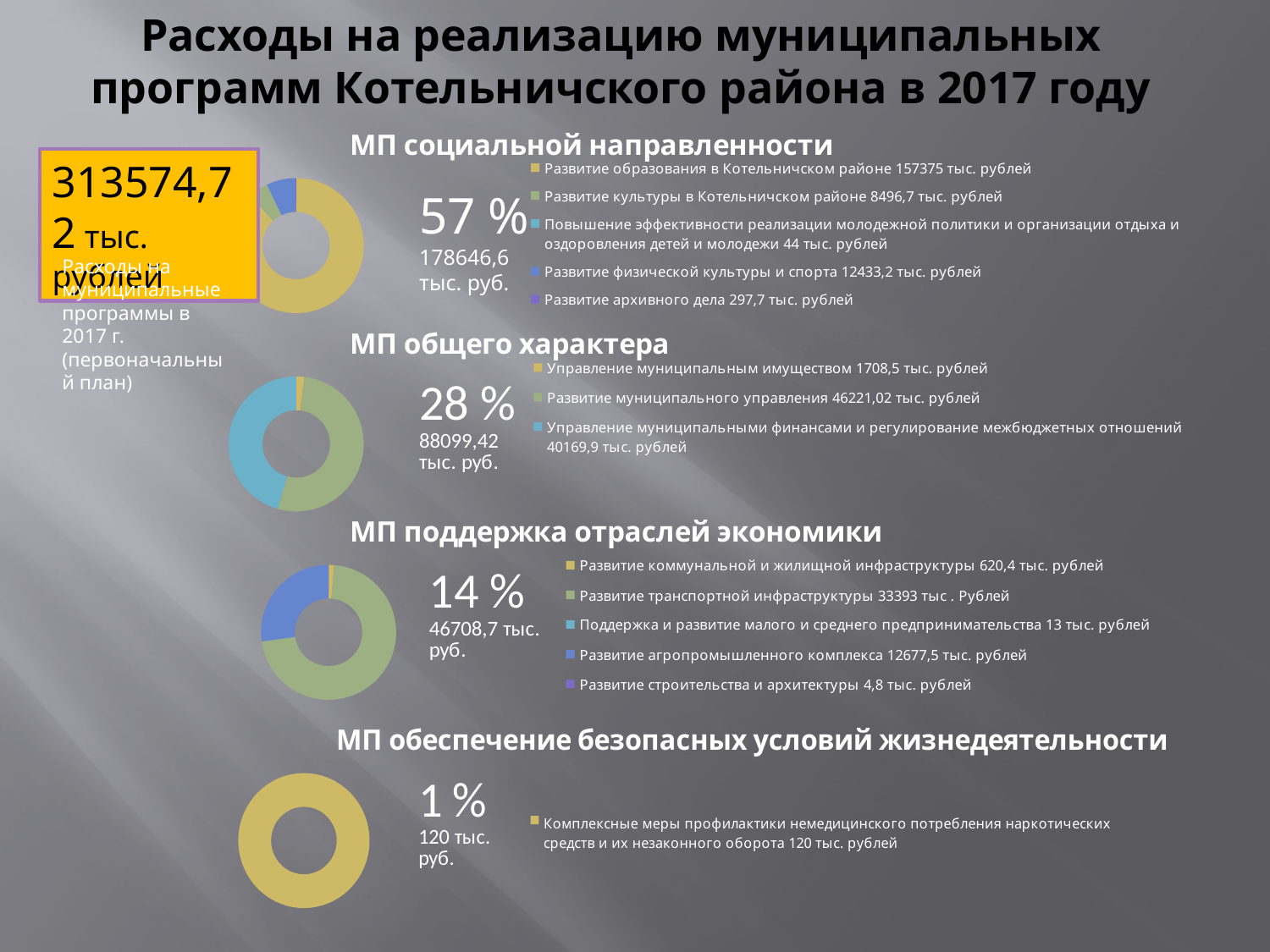
What total amount in тыс. руб. is shown next to the "МП обеспечение безопасных условий жизнедеятельности" chart? 120 тыс. руб. In the "МП поддержка отраслей экономики" chart, what is the value for "Развитие агропромышленного комплекса"? 12677,5 тыс. рублей How many categories does the legend of the "МП социальной направленности" chart list? 5 In the "МП общего характера" chart, which category has the highest value? Развитие муниципального управления What kind of chart is used for "МП социальной направленности"? Doughnut (pie) chart What share of total expenditure does the "МП общего характера" chart represent? 28 % In the "МП поддержка отраслей экономики" chart, which is larger: "Развитие транспортной инфраструктуры" or "Развитие коммунальной и жилищной инфраструктуры"? Развитие транспортной инфраструктуры In the "МП социальной направленности" chart, which category has the lowest value? Повышение эффективности реализации молодежной политики и организации отдыха и оздоровления детей и молодежи In the "МП социальной направленности" chart, what is the value for "Развитие образования в Котельничском районе"? 157375 тыс. рублей What total expenditure on municipal programmes is shown in the yellow box on the slide? 313574,72 тыс. рублей How many categories does the legend of the "МП поддержка отраслей экономики" chart list? 5 In the "МП общего характера" chart, what is the difference between "Развитие муниципального управления" and "Управление муниципальными финансами и регулирование межбюджетных отношений"? 6051,12 тыс. рублей